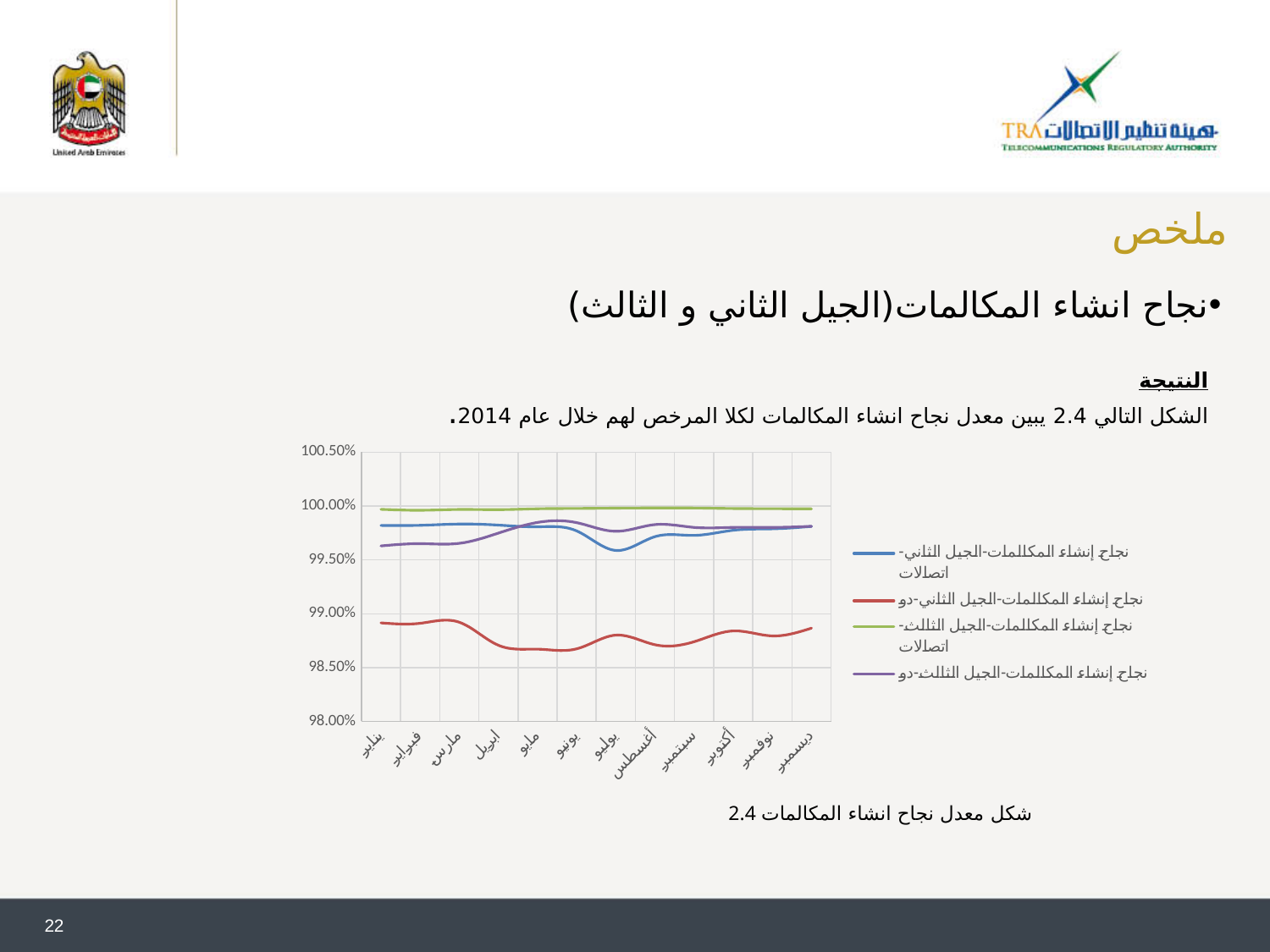
How many series does the chart legend list? 4 What colour is the line for نجاح إنشاء المكالمات-الجيل الثاني-دو in the chart? red Is the value for نجاح إنشاء المكالمات-الجيل الثاني-اتصالات in يناير greater or less than 99.50%? greater What is the highest value shown on the chart's y axis? 100.50% Which series has the highest values throughout the year in the chart? نجاح إنشاء المكالمات-الجيل الثالث-اتصالات How many months are shown along the x axis of the chart? 12 Is the value for نجاح إنشاء المكالمات-الجيل الثالث-دو in أبريل greater or less than 99.00%? greater Which series has the lowest values throughout the year in the chart? نجاح إنشاء المكالمات-الجيل الثاني-دو Is the value for نجاح إنشاء المكالمات-الجيل الثاني-دو in يونيو greater or less than 99.00%? less What kind of chart is shown on the slide? line chart In ديسمبر, which is larger: the value for نجاح إنشاء المكالمات-الجيل الثاني-اتصالات or for نجاح إنشاء المكالمات-الجيل الثاني-دو? نجاح إنشاء المكالمات-الجيل الثاني-اتصالات